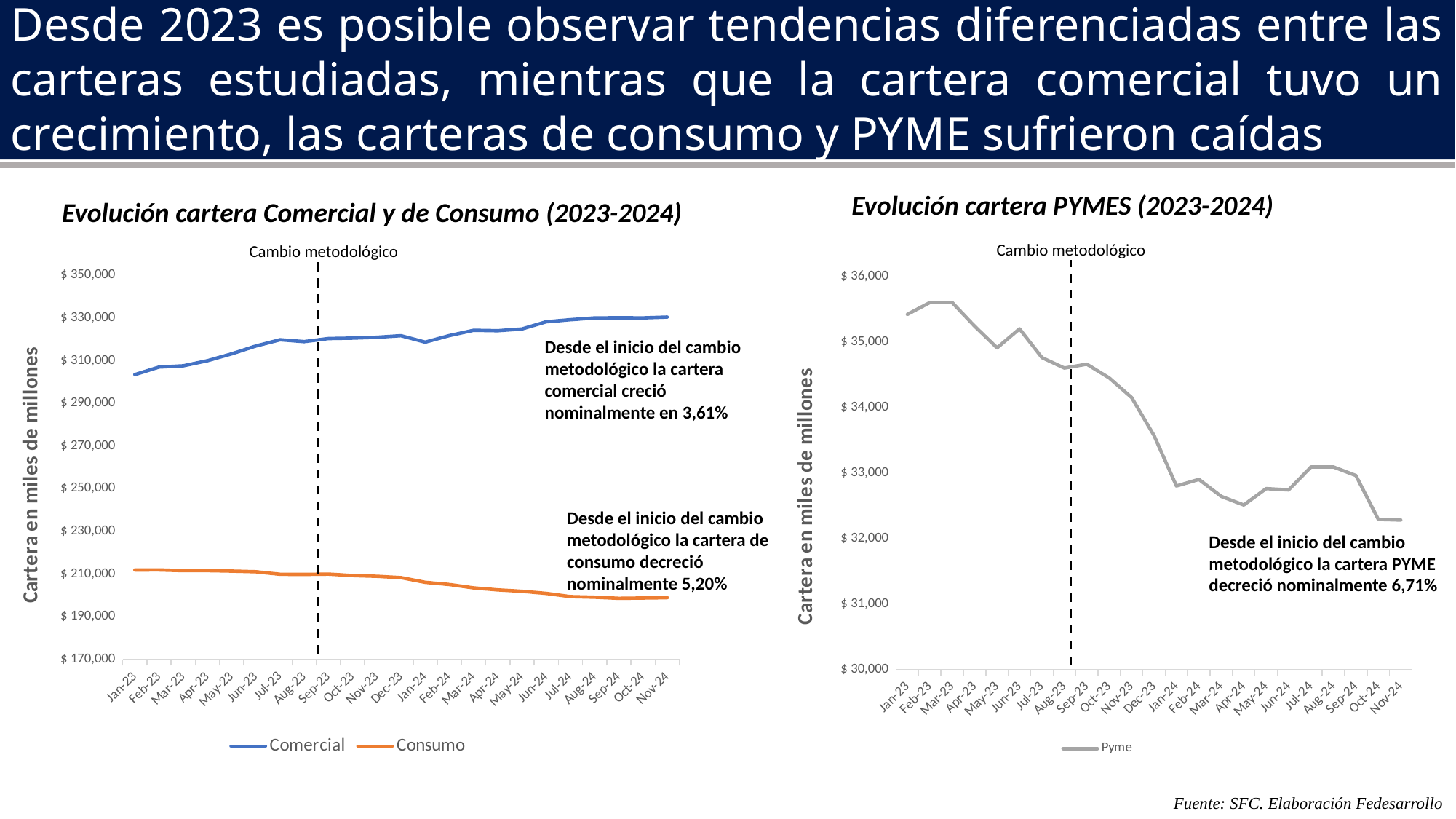
What kind of chart is the 'Evolución cartera Comercial y de Consumo (2023-2024)' chart? line chart In the 'Evolución cartera Comercial y de Consumo (2023-2024)' chart, is the Consumo value for Nov-24 greater or less than $ 210,000? less How many series does the legend of the 'Evolución cartera Comercial y de Consumo (2023-2024)' chart list? 2 In the 'Evolución cartera Comercial y de Consumo (2023-2024)' chart, does the Consumo series rise or fall from Jan-23 to Nov-24? fall In the 'Evolución cartera Comercial y de Consumo (2023-2024)' chart, does the Comercial series rise or fall from Jan-23 to Nov-24? rise In the 'Evolución cartera Comercial y de Consumo (2023-2024)' chart, which series has the higher value in Nov-24, Comercial or Consumo? Comercial What is the y-axis label of the 'Evolución cartera PYMES (2023-2024)' chart? Cartera en miles de millones In the 'Evolución cartera PYMES (2023-2024)' chart, does the Pyme series rise or fall from Jan-23 to Nov-24? fall In the 'Evolución cartera PYMES (2023-2024)' chart, is the Pyme value for Nov-24 greater or less than $ 33,000? less In the 'Evolución cartera PYMES (2023-2024)' chart, is the Pyme value for Jan-23 greater or less than $ 35,000? greater How many monthly points are plotted on the x axis of the 'Evolución cartera PYMES (2023-2024)' chart? 23